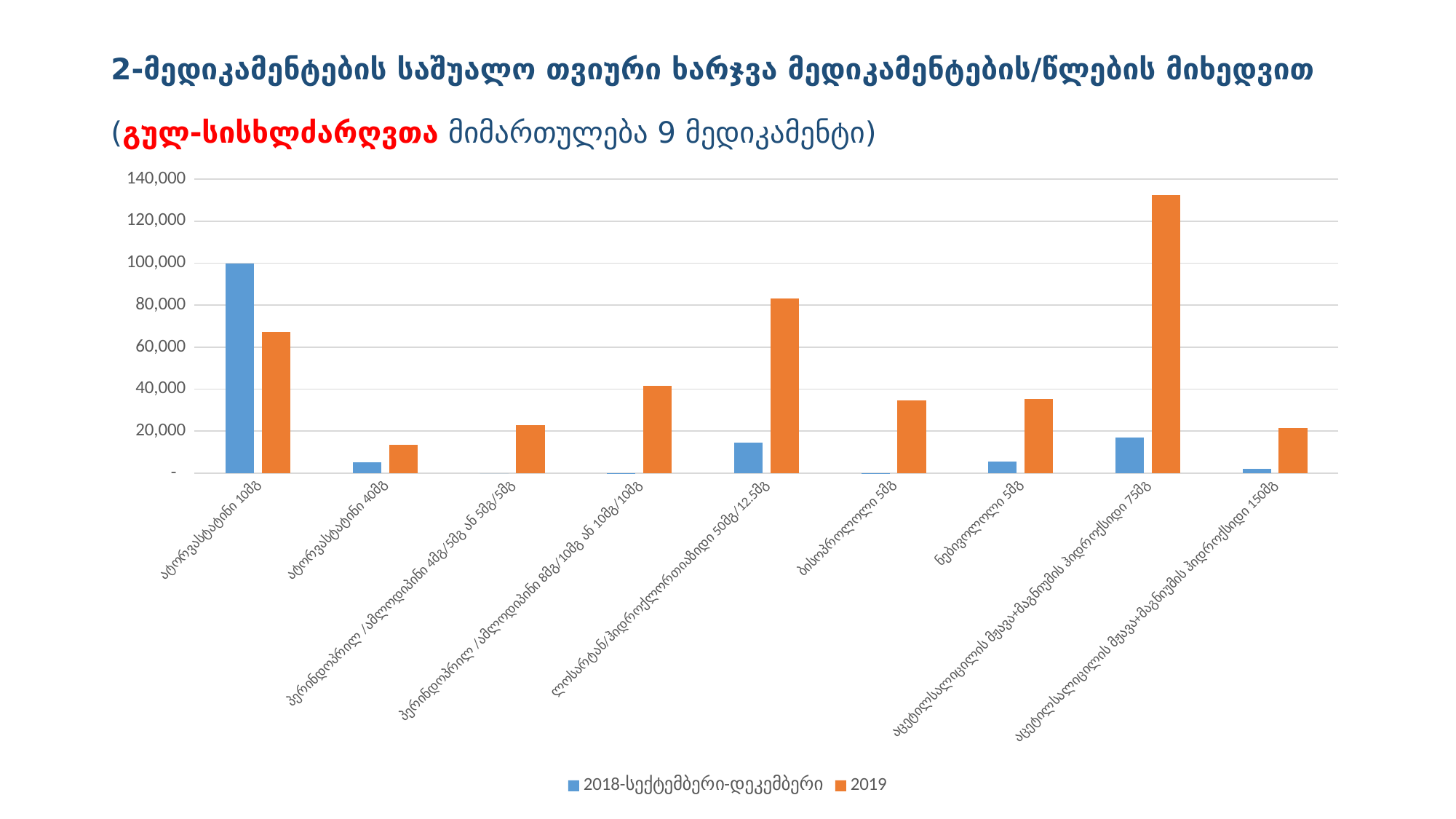
Which category has the highest 2019 value? აცეტილსალიცილის მჟავა+მაგნიუმის ჰიდროქსიდი 75მგ For ატორვასტატინი 10მგ, which series has the larger value: 2018-სექტემბერი-დეკემბერი or 2019? 2018-სექტემბერი-დეკემბერი How many series does the legend list? 2 How many medication categories are shown on the x axis? 9 Is the 2019 value for აცეტილსალიცილის მჟავა+მაგნიუმის ჰიდროქსიდი 75მგ greater or less than 120,000? greater What kind of chart is shown on the slide? bar chart Is the 2019 value for ატორვასტატინი 10მგ greater or less than 80,000? less Is the 2019 value for ლოსარტან/ჰიდროქლორთიაზიდი 50მგ/12.5მგ greater or less than 80,000? greater Which is larger: the 2019 value for ნებივოლოლი 5მგ or the 2019 value for ლოსარტან/ჰიდროქლორთიაზიდი 50მგ/12.5მგ? ლოსარტან/ჰიდროქლორთიაზიდი 50მგ/12.5მგ Which category has the highest value for the 2018-სექტემბერი-დეკემბერი series? ატორვასტატინი 10მგ Which colour represents the 2019 series in the chart? orange